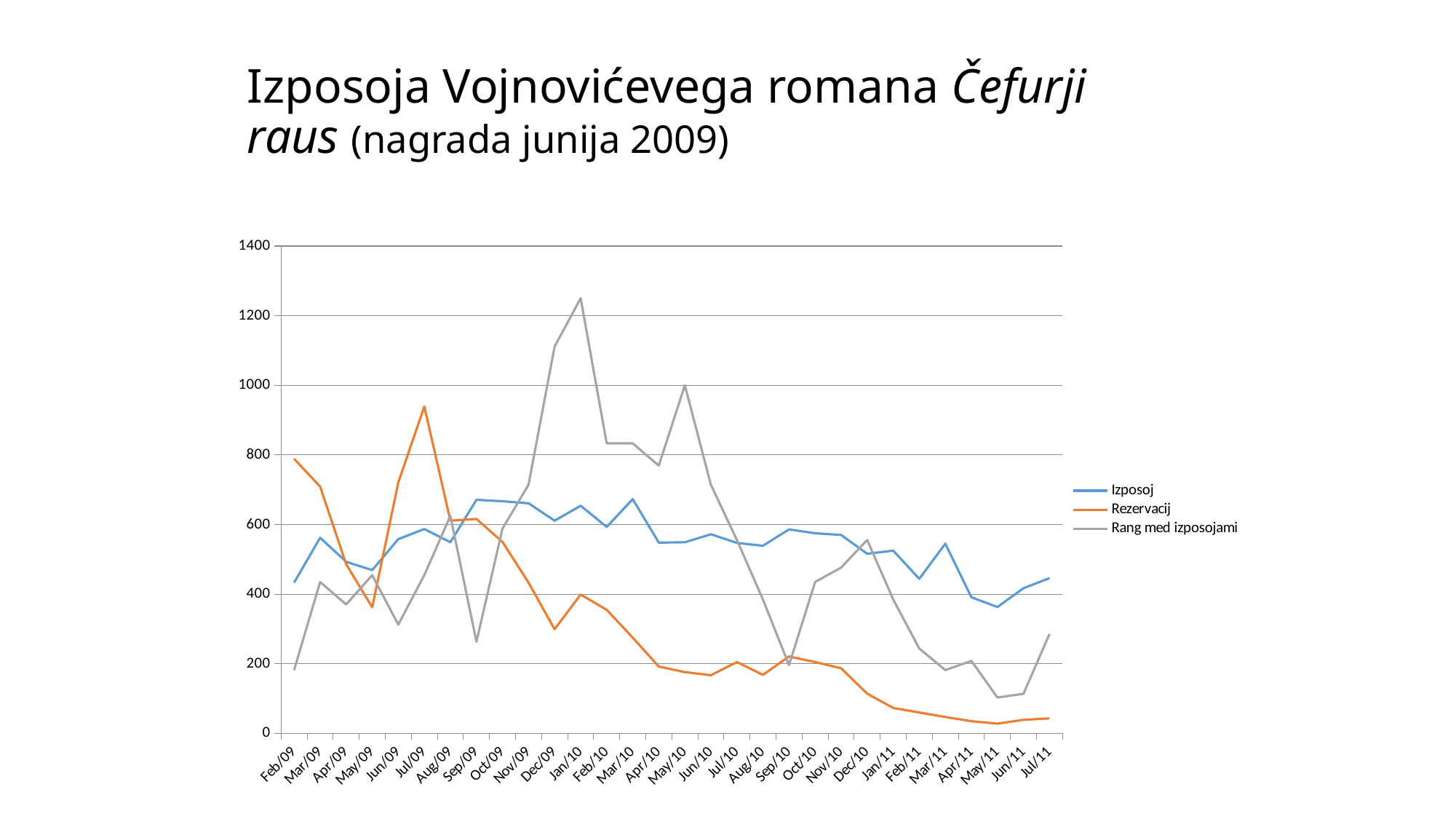
In which month does the Rang med izposojami series reach its highest value? Jan/10 How many series does the legend list? 3 Is the value of Rang med izposojami in Jan/10 greater or less than 1200? greater Is the value of Rezervacij in Jul/11 greater or less than 200? less Which series is drawn in orange? Rezervacij How many months are plotted along the x axis? 30 Is the value of Izposoj in Oct/09 greater or less than 600? greater Does the Rezervacij series rise or fall overall from Jan/10 to Jul/11? fall What kind of chart is shown on the slide? line chart In which month does the Rezervacij series reach its highest value? Jul/09 In Feb/09, which is larger: Izposoj or Rezervacij? Rezervacij